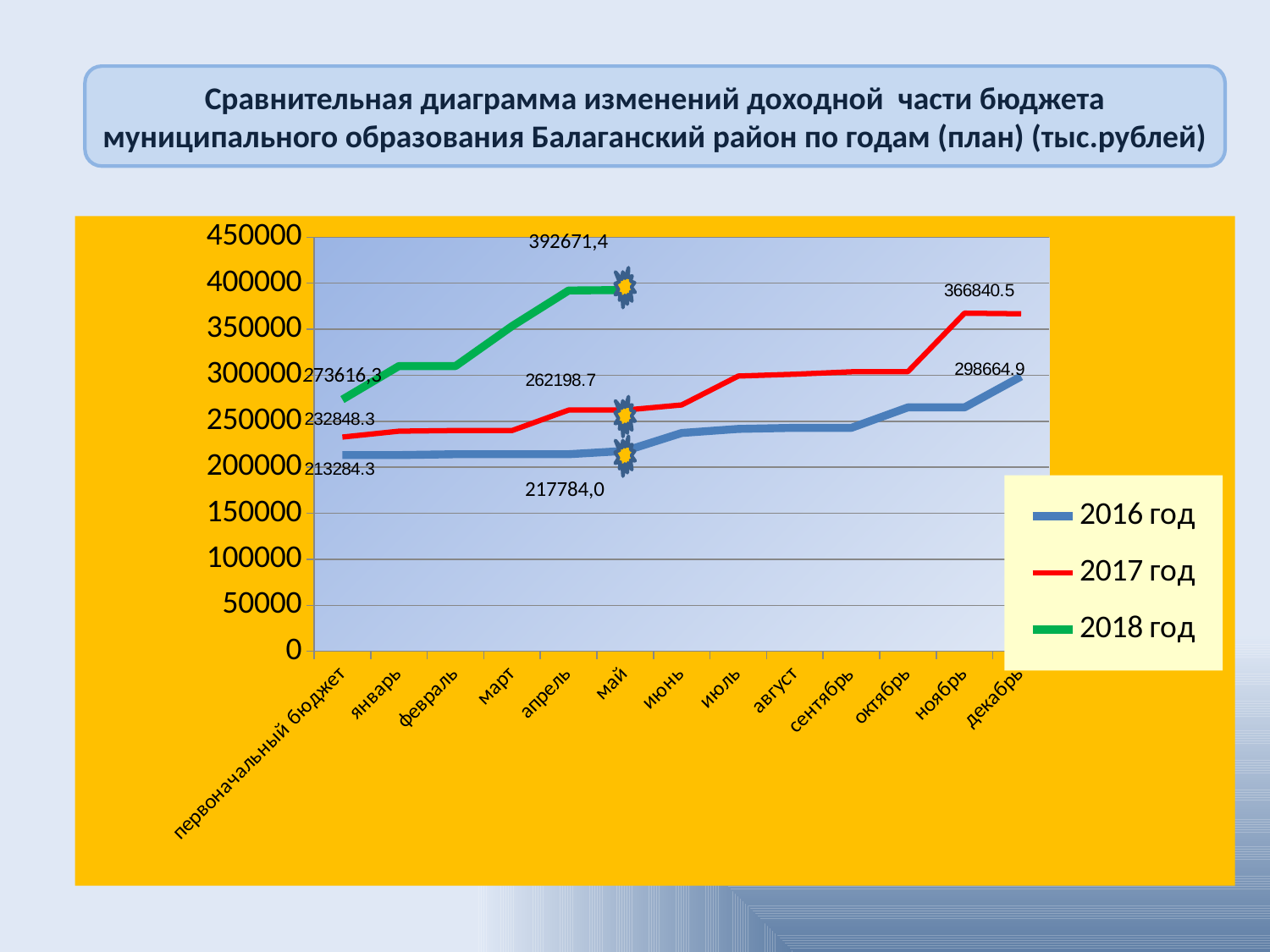
Which series has the highest value in май? 2018 год How many categories are shown along the x axis? 13 What kind of chart is shown on the slide? line chart What is the value for 2018 год at первоначальный бюджет? 273616,3 What is the value for 2016 год in декабрь? 298664.9 What is the value for 2018 год in май? 392671,4 Is the value for 2017 год in июль greater or less than 250000? greater How many series does the legend list? 3 What is the value for 2016 год at первоначальный бюджет? 213284.3 What is the difference between the 2017 год and 2016 год values at первоначальный бюджет? 19564 What is the value for 2017 год at первоначальный бюджет? 232848.3